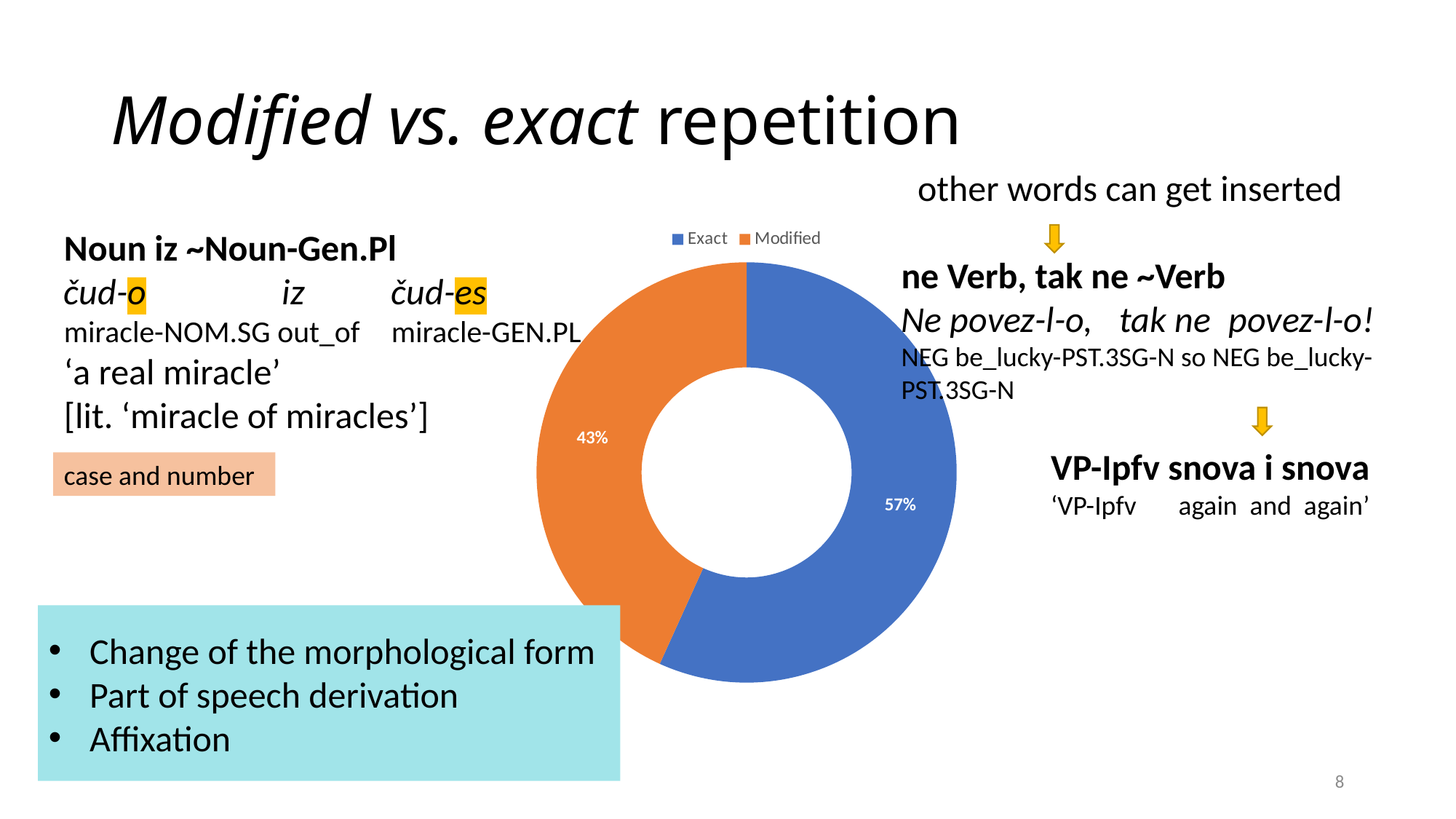
What kind of chart is shown on the slide? Doughnut (pie) chart Which category has the larger share in the chart, Exact or Modified? Exact What colour represents the Modified category in the chart? Orange Is the share for Exact greater or less than 50%? greater How many entries does the chart legend list? 2 What colour represents the Exact category in the chart? Blue How many categories does the chart show? 2 What share of the doughnut chart is labelled Modified? 43% What is the difference in percentage points between the Exact and Modified shares? 14 Which category has the largest share in the chart? Exact What share of the doughnut chart is labelled Exact? 57% Which category has the smallest share in the chart? Modified